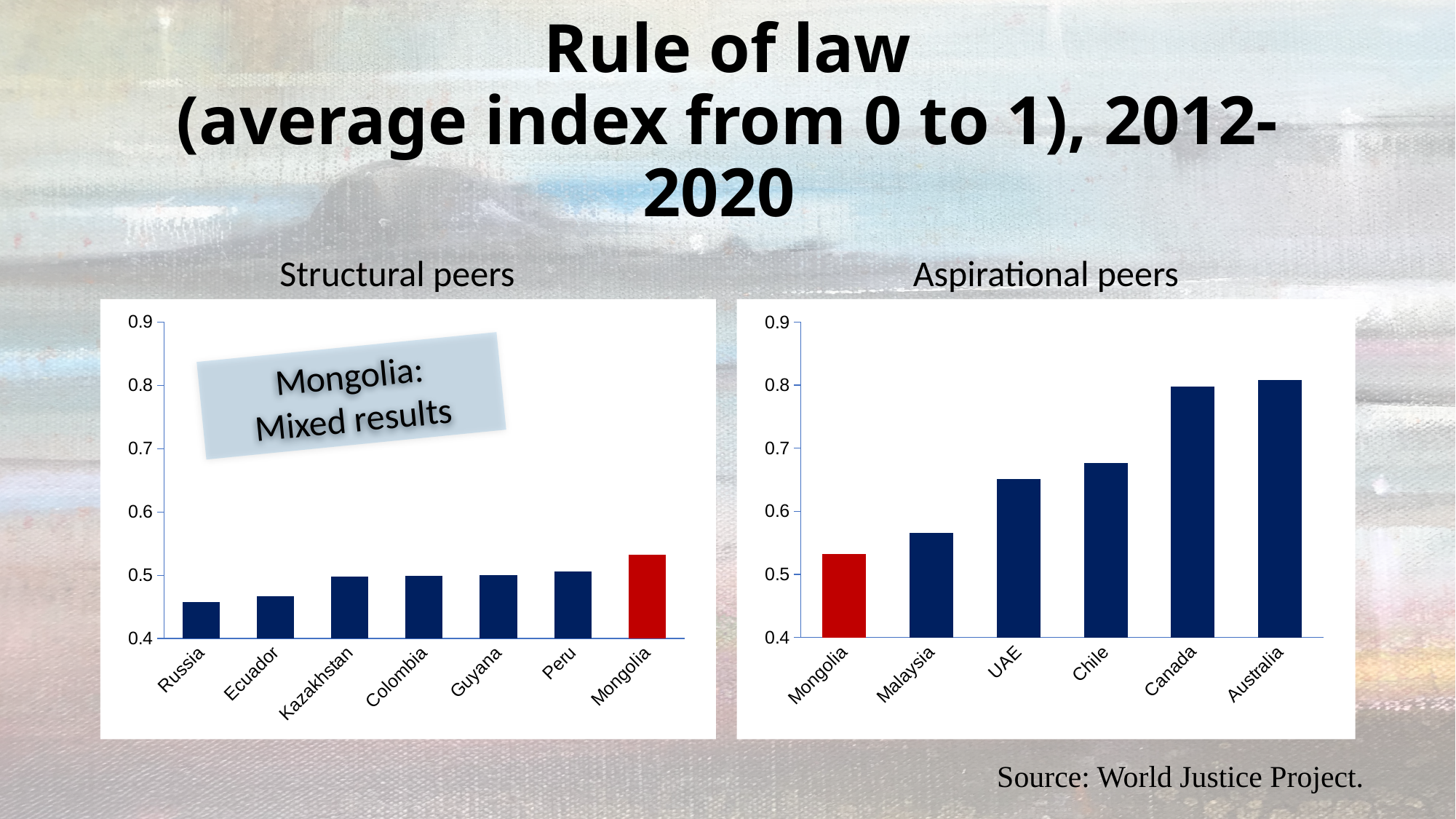
In the Aspirational peers chart, which is larger, the value for Chile or the value for UAE? Chile In the Structural peers chart, what colour is the bar for Mongolia? red In the Aspirational peers chart, is the value for Malaysia greater or less than 0.6? less In the Aspirational peers chart, is the value for Canada greater or less than 0.7? greater In the Aspirational peers chart, which country has the lowest value? Mongolia In the Structural peers chart, which country has the highest value? Mongolia In the Aspirational peers chart, which country has the highest value? Australia How many countries are shown in the Structural peers chart? 7 How many countries are shown in the Aspirational peers chart? 6 What kind of chart is the Structural peers chart? bar chart In the Aspirational peers chart, do the values rise or fall from left to right? rise In the Structural peers chart, is the value for Russia greater or less than 0.5? less